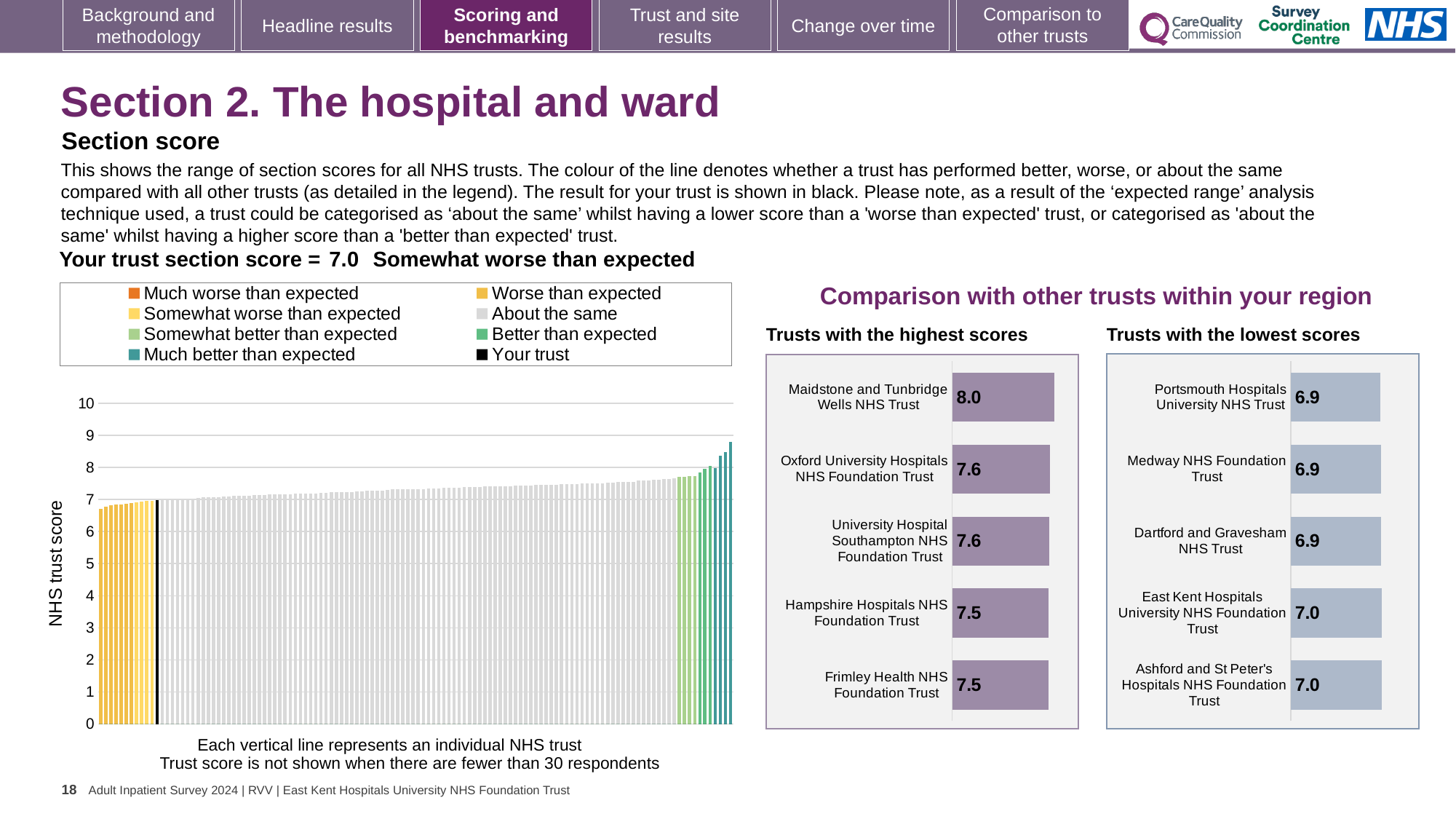
How many trusts are shown in the 'Trusts with the lowest scores' chart? 5 In the 'Trusts with the highest scores' chart, what is the difference between the scores of Maidstone and Tunbridge Wells NHS Trust and Hampshire Hospitals NHS Foundation Trust? 0.5 How many entries does the legend of the large chart on the left list? 8 In the 'Trusts with the lowest scores' chart, which has the larger score: Ashford and St Peter's Hospitals NHS Foundation Trust or Medway NHS Foundation Trust? Ashford and St Peter's Hospitals NHS Foundation Trust In the 'Trusts with the highest scores' chart, what is the score for Frimley Health NHS Foundation Trust? 7.5 What kind of chart is the large chart on the left showing NHS trust scores? Bar chart In the 'Trusts with the lowest scores' chart, what is the score for Portsmouth Hospitals University NHS Trust? 6.9 In the large chart on the left showing NHS trust scores, do the values rise or fall from left to right? Rise In the 'Trusts with the highest scores' chart, which trust has the highest score? Maidstone and Tunbridge Wells NHS Trust In the 'Trusts with the highest scores' chart, what is the score for Maidstone and Tunbridge Wells NHS Trust? 8.0 How many trusts are shown in the 'Trusts with the highest scores' chart? 5 In the 'Trusts with the lowest scores' chart, what is the score for East Kent Hospitals University NHS Foundation Trust? 7.0